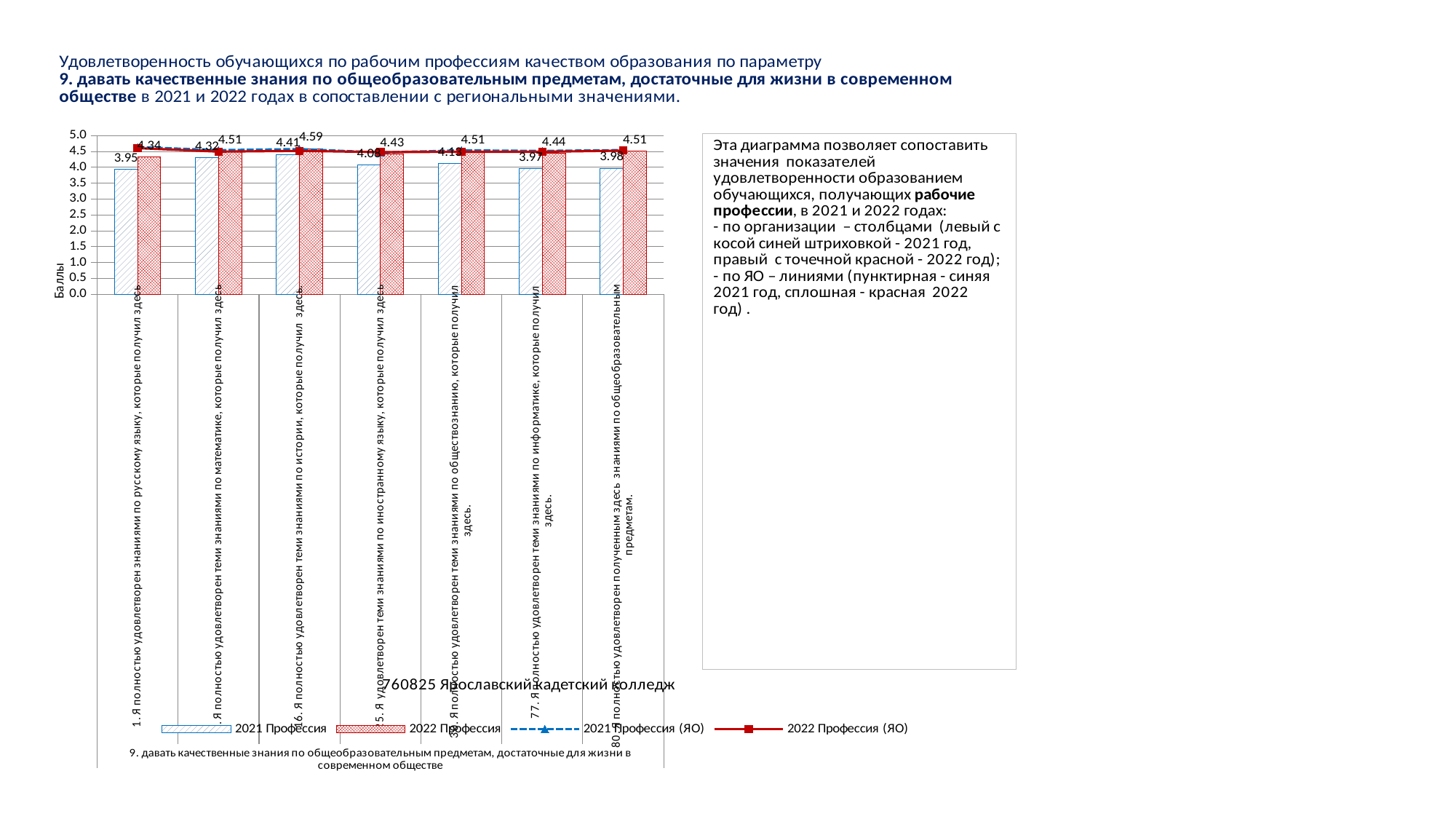
Which category has the lowest 2021 Профессия bar? 1. Я полностью удовлетворен знаниями по русскому языку, которые получил здесь (3.95) What is the 2021 Профессия value for the category about knowledge of информатика (computer science)? 3.97 What is the 2022 Профессия value for the category about knowledge of математика (mathematics)? 4.51 Which is larger: the 2021 Профессия value for математика or the 2021 Профессия value for иностранный язык? математика (4.32) What is the 2021 Профессия value for the category about knowledge of русский язык (Russian language)? 3.95 How many categories are shown on the x axis of the chart? 7 What is the 2022 Профессия value for the category about knowledge of история (history)? 4.59 What is the difference between the 2022 and 2021 Профессия values for the история category? 0.18 Is the 2021 Профессия (ЯО) line value for the русский язык category greater or less than 4.0? greater How many series does the chart legend list? 4 What is the difference between the 2022 and 2021 Профессия values for the русский язык category? 0.39 Which category has the highest 2022 Профессия bar? 16. Я полностью удовлетворен теми знаниями по истории, которые получил здесь (4.59)